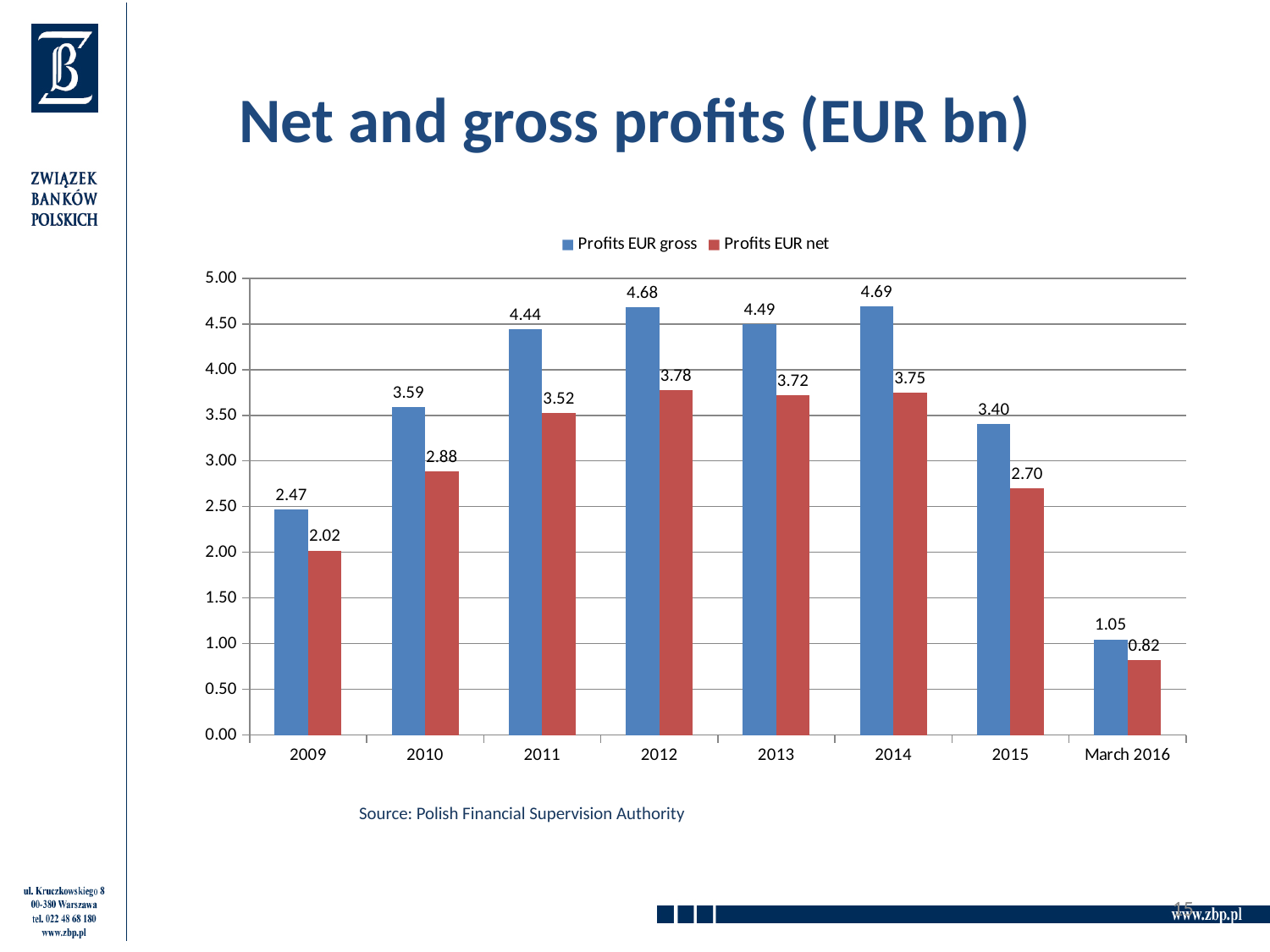
Which is larger: Profits EUR net in 2012 or Profits EUR net in 2014? Profits EUR net in 2012 Which category has the highest value for Profits EUR gross? 2014 Is the value of Profits EUR gross for 2011 greater or less than 4.00? greater What is the value of Profits EUR net for March 2016? 0.82 What is the title of the chart? Net and gross profits (EUR bn) How many series does the legend list? 2 How many categories are shown on the x axis? 8 What is the difference between Profits EUR gross and Profits EUR net in 2015? 0.70 What is the value of Profits EUR net for 2010? 2.88 What is the value of Profits EUR gross for 2012? 4.68 What kind of chart is shown on the slide? Bar chart Which category has the lowest value for Profits EUR net? March 2016